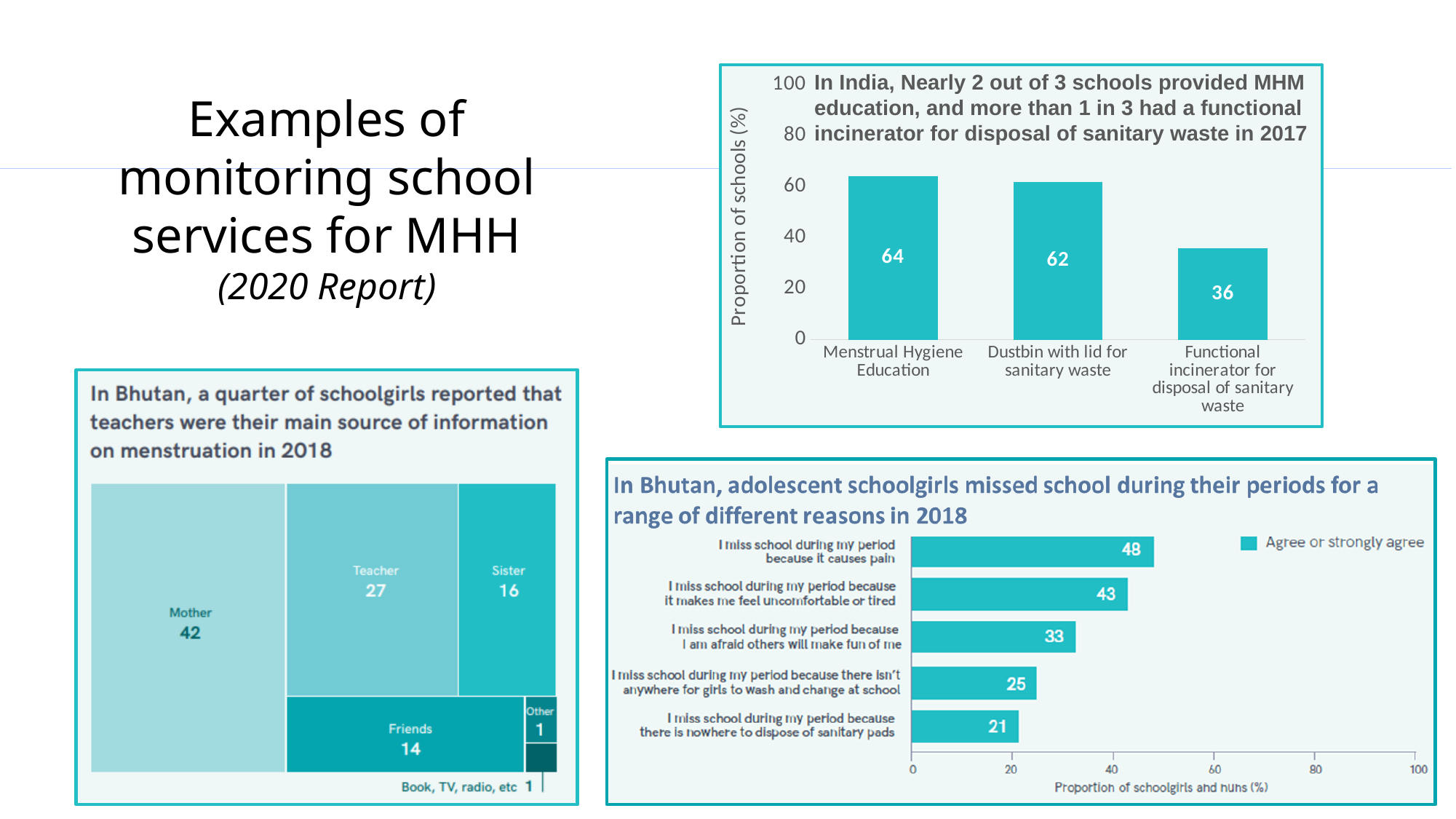
In the Bhutan treemap (bottom left), what value is shown for Mother? 42 In the Bhutan treemap (bottom left), what is the difference between Mother and Friends? 28 In the India chart (top right), how many categories are shown? 3 In the India chart (top right), what proportion of schools provided Menstrual Hygiene Education? 64 In the Bhutan missed-school chart (bottom right), which reason has the lowest value? I miss school during my period because there is nowhere to dispose of sanitary pads What kind of chart is the India chart (top right)? Bar chart In the Bhutan missed-school chart (bottom right), what is the x-axis label? Proportion of schoolgirls and nuns (%) In the Bhutan treemap (bottom left), which is larger, Teacher or Sister? Teacher In the India chart (top right), what is the difference between the values for Menstrual Hygiene Education and Functional incinerator for disposal of sanitary waste? 28 In the Bhutan missed-school chart (bottom right), how many series does the legend list? 1 In the Bhutan missed-school chart (bottom right), what is the value for 'I miss school during my period because it causes pain'? 48 In the India chart (top right), which category has the lowest proportion of schools? Functional incinerator for disposal of sanitary waste